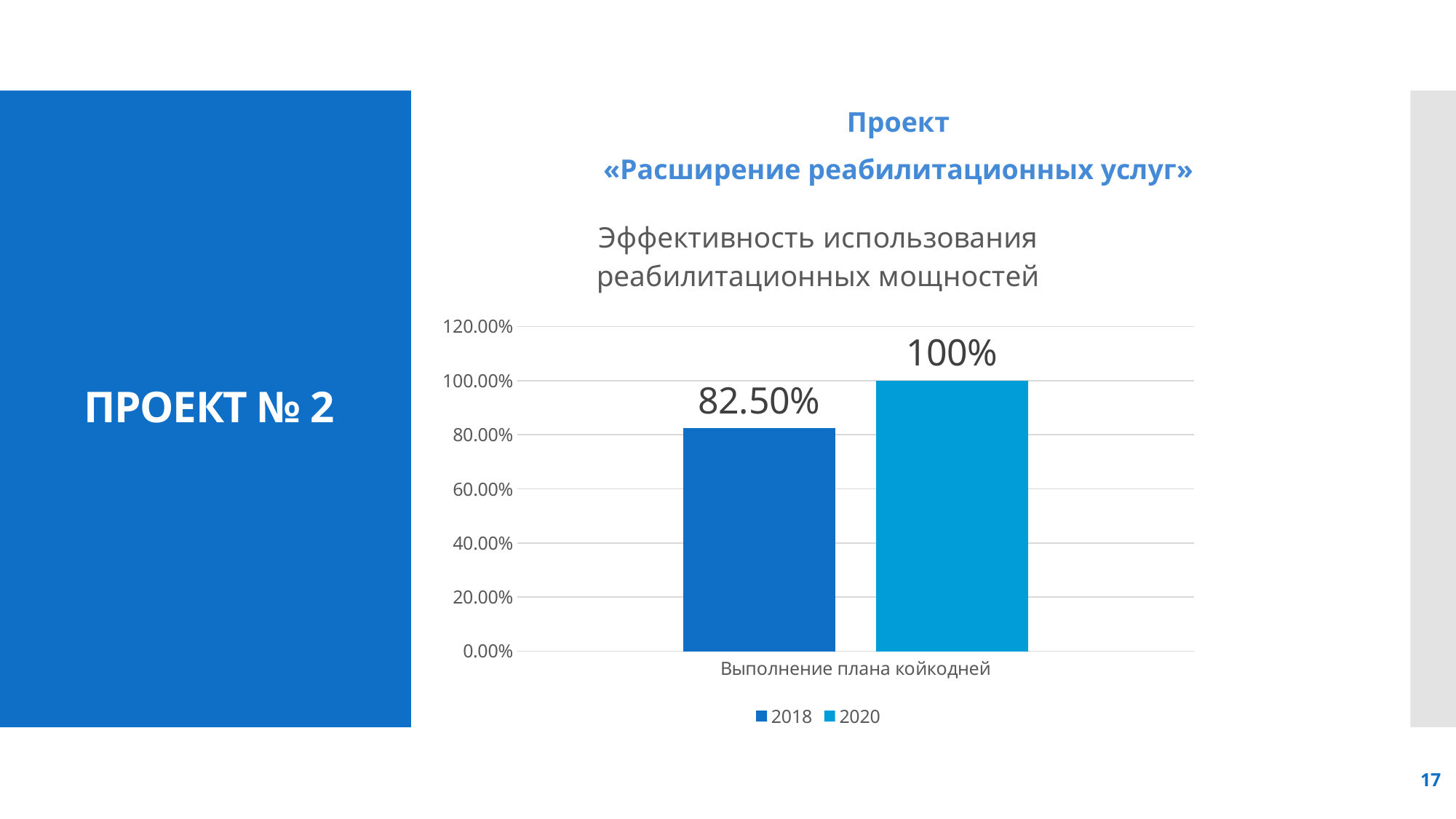
What is the title of the chart? Эффективность использования реабилитационных мощностей Which series has the higher value, 2018 or 2020? 2020 Is the value for 2018 greater or less than 80.00%? greater How many series does the legend list? 2 How many categories are shown on the x axis? 1 What is the difference between the 2020 value and the 2018 value? 17.50% What is the value for 2020 in the chart? 100% What kind of chart is shown on the slide? Bar chart What is the category label on the x axis? Выполнение плана койкодней What is the value for 2018 in the chart? 82.50% Which series has the lowest value in the chart? 2018 Is the value for 2020 greater or less than 120.00%? less